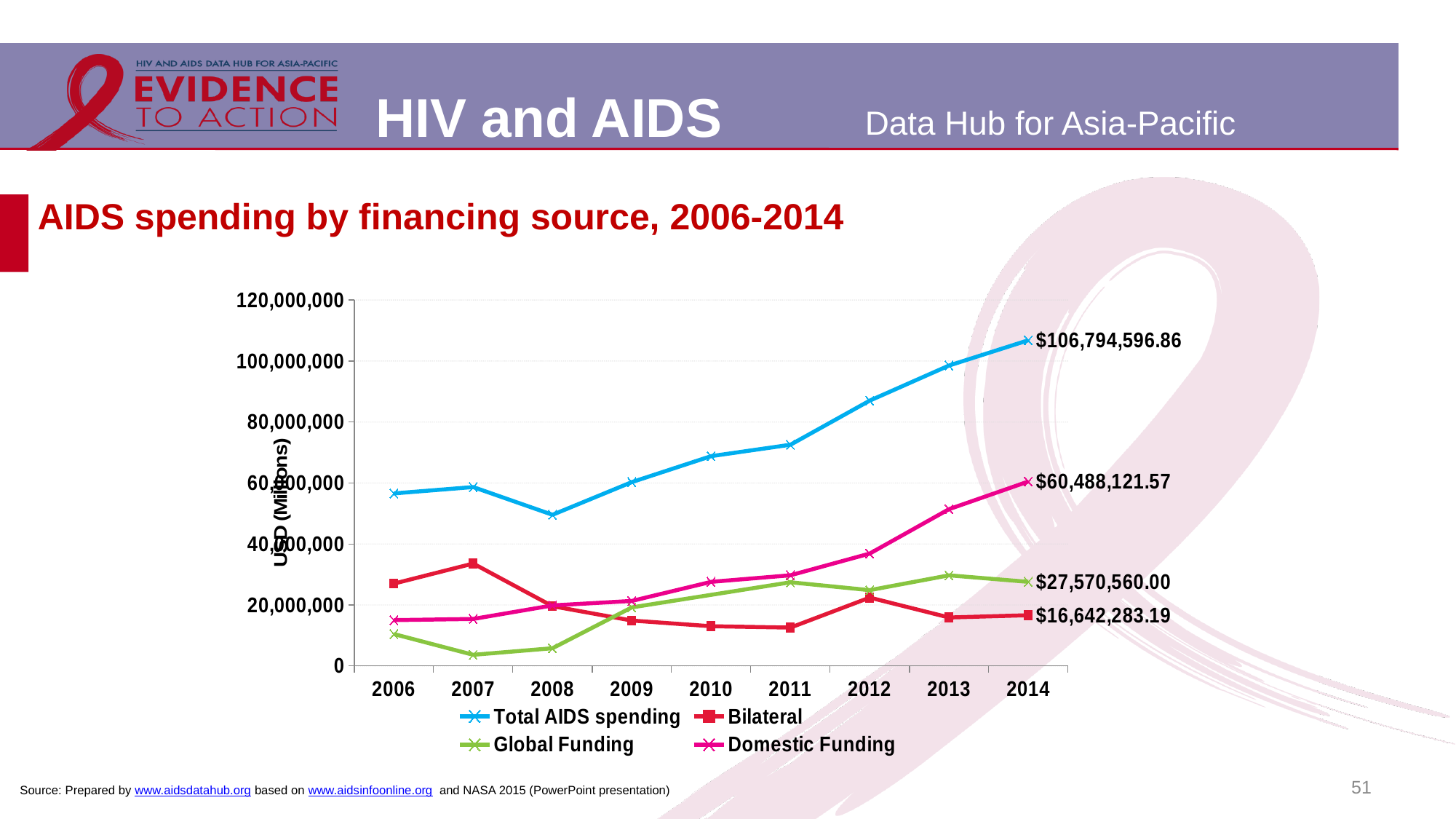
Is the value for Total AIDS spending in 2008 greater or less than 60,000,000? less How many years are shown on the x axis? 9 What kind of chart is shown on the slide? Line chart What is the data label for Domestic Funding in 2014? $60,488,121.57 What is the data label for Total AIDS spending in 2014? $106,794,596.86 How many series does the legend list? 4 What is the data label for Global Funding in 2014? $27,570,560.00 Is the value for Bilateral in 2007 greater or less than 20,000,000? greater What is the data label for Bilateral in 2014? $16,642,283.19 In 2014, which is larger: Domestic Funding or Global Funding? Domestic Funding Which series has the lowest value in 2014? Bilateral What is the difference between Total AIDS spending and Domestic Funding in 2014? $46,306,475.29